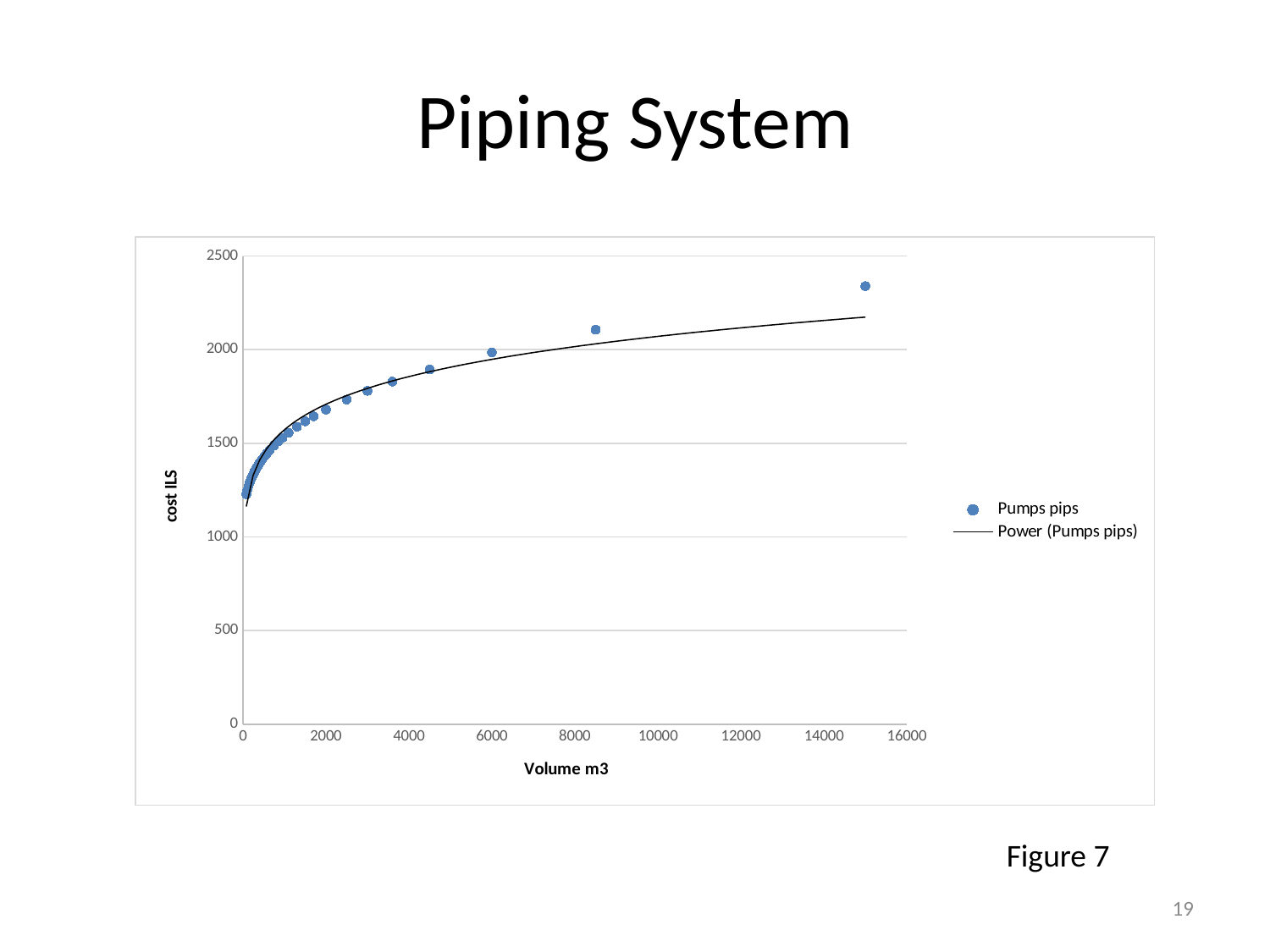
Is the cost value for the point at a volume of 2000 greater or less than 1500? greater Which plotted point has the highest cost: the one at a volume of 15000 or the one at a volume of 8500? the one at 15000 Is the cost value for the point at a volume of 4500 greater or less than 2000? less Is the cost value for the point at a volume of 15000 greater or less than 2000? greater What is the label of the y axis? cost ILS What kind of chart is shown on the slide? scatter chart What is the name of the trendline series in the legend? Power (Pumps pips) What is the label of the x axis? Volume m3 How many entries does the chart legend list? 2 Do the plotted cost values rise or fall as volume increases along the x axis? rise